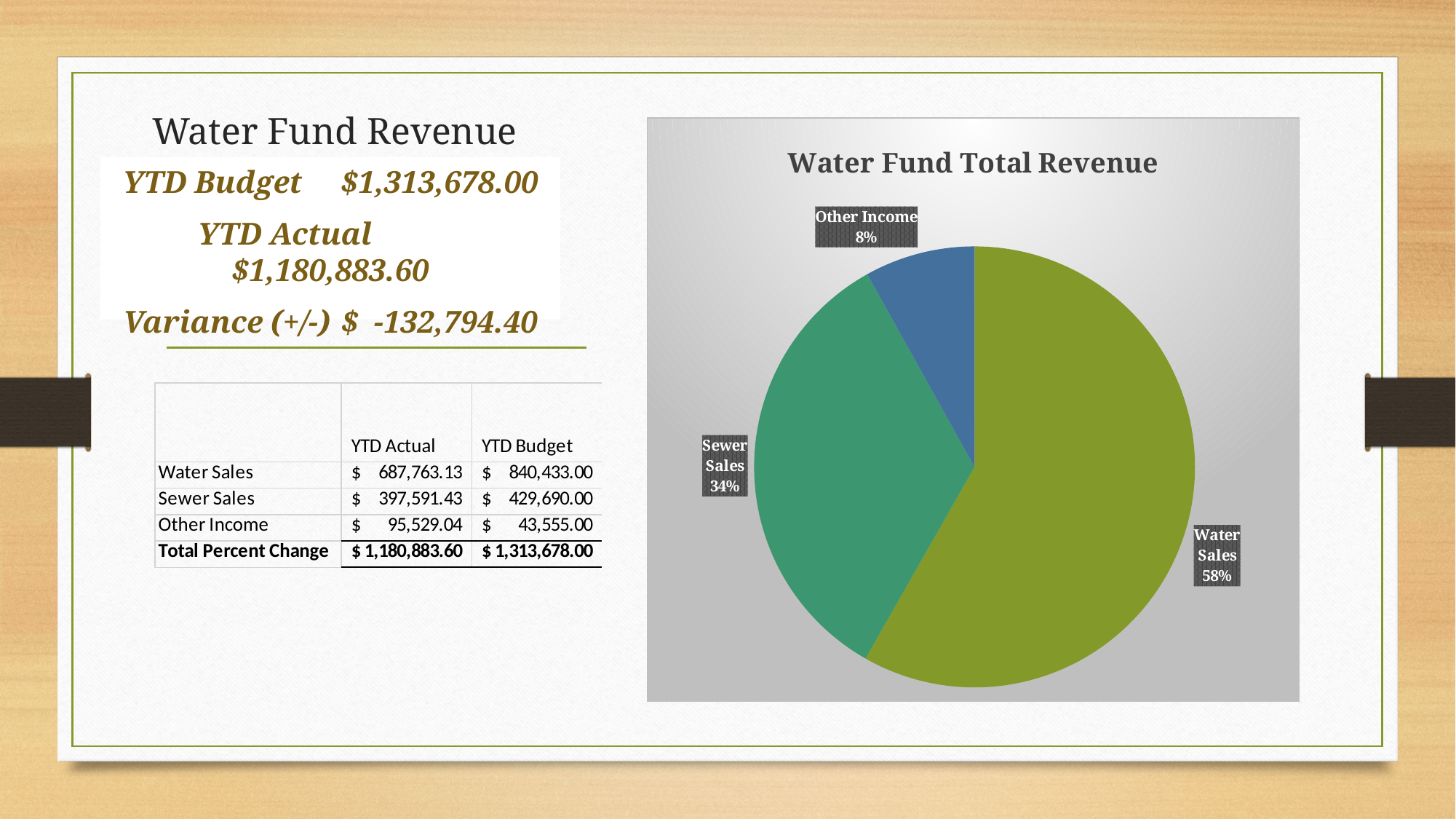
How many slices does the pie chart have? 3 Which is larger, the Sewer Sales slice or the Other Income slice? Sewer Sales Which slice of the pie is the largest? Water Sales What is the difference in percentage points between the Sewer Sales and Other Income slices? 26 Which slice of the pie is the smallest? Other Income What share of the pie does Other Income represent? 8% What share of the pie does Sewer Sales represent? 34% What is the difference in percentage points between the Water Sales and Sewer Sales slices? 24 What is the title of the chart? Water Fund Total Revenue What share of the pie does Water Sales represent? 58% What colour is the Other Income slice? blue What kind of chart is shown on the slide? pie chart